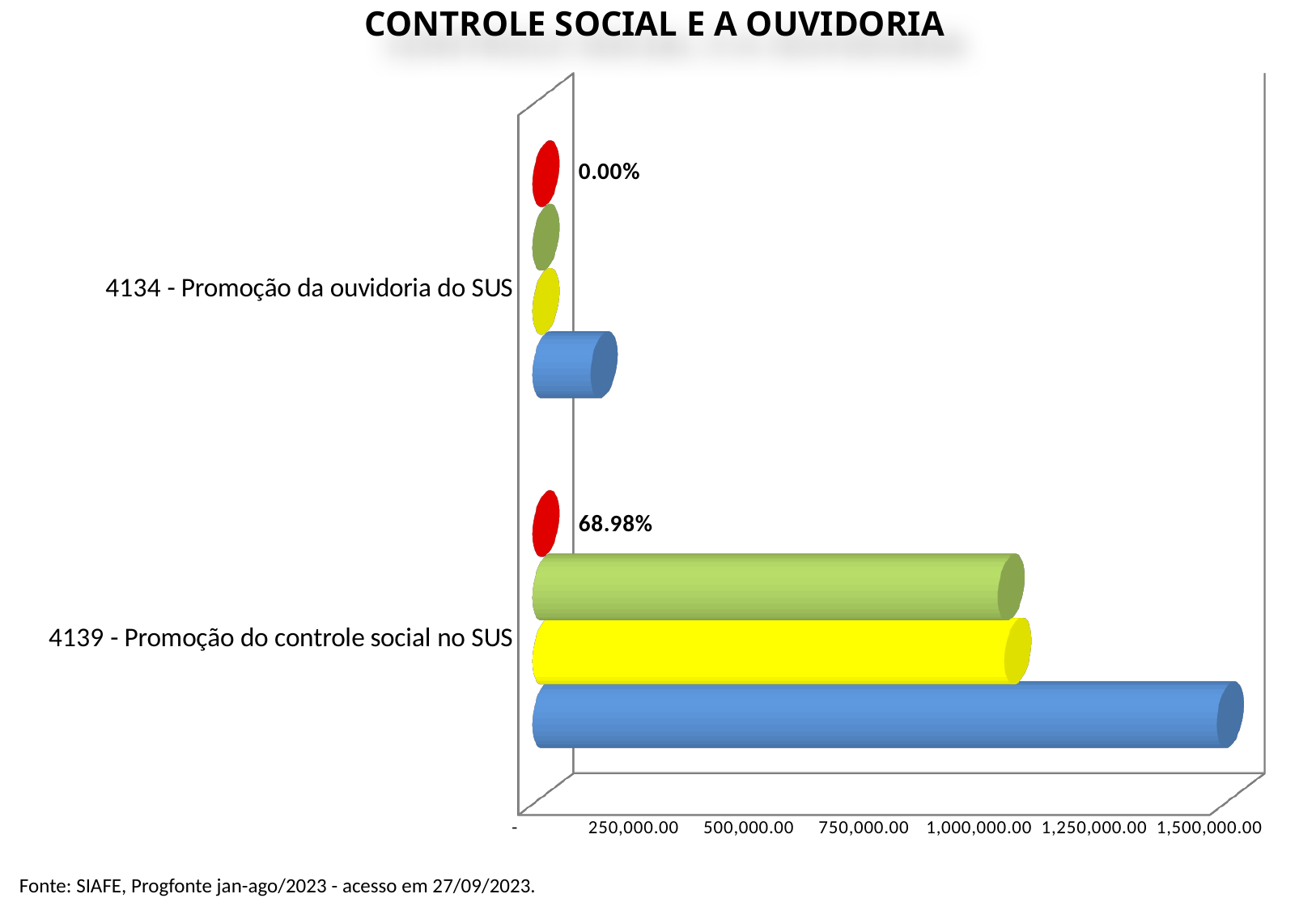
What is the title of the chart? CONTROLE SOCIAL E A OUVIDORIA How many categories are shown on the chart? 2 What source is cited below the chart? Fonte: SIAFE, Progfonte jan-ago/2023 - acesso em 27/09/2023. Which category has the higher percentage label, 4134 or 4139? 4139 - Promoção do controle social no SUS What kind of chart is shown on the slide? bar chart Is the value of the green bar for '4139 - Promoção do controle social no SUS' greater or less than 750,000.00? greater Is the value of the blue bar for '4139 - Promoção do controle social no SUS' greater or less than 1,250,000.00? greater What is the difference between the percentage labels of 4139 and 4134? 68.98% What percentage label is shown for '4139 - Promoção do controle social no SUS'? 68.98% Is the value of the blue bar for '4134 - Promoção da ouvidoria do SUS' greater or less than 250,000.00? less Which category has the longest bar on the chart? 4139 - Promoção do controle social no SUS What percentage label is shown for '4134 - Promoção da ouvidoria do SUS'? 0.00%